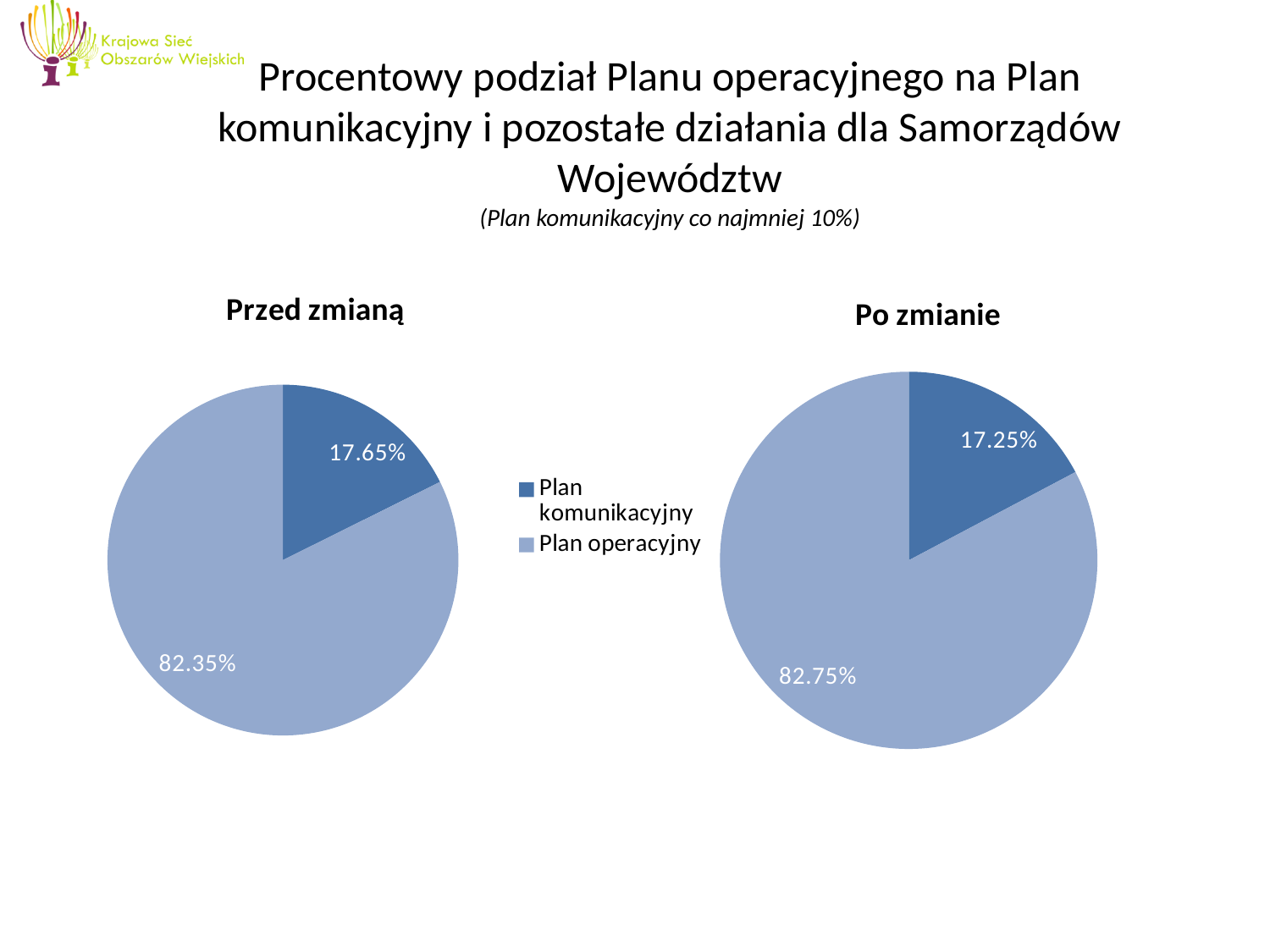
In the "Po zmianie" chart, what share does Plan operacyjny have? 82.75% In the "Przed zmianą" chart, what share does Plan komunikacyjny have? 17.65% In the "Po zmianie" chart, what share does Plan komunikacyjny have? 17.25% Is the Plan komunikacyjny share larger in the "Przed zmianą" chart or the "Po zmianie" chart? Przed zmianą In the "Przed zmianą" chart, what is the difference between the Plan operacyjny and Plan komunikacyjny shares? 64.70% How many slices does the "Przed zmianą" pie chart have? 2 How many entries does the legend list? 2 What type of chart is the "Po zmianie" chart? Pie chart What is the title of the chart on the right side of the slide? Po zmianie In the "Przed zmianą" chart, which category has the largest slice? Plan operacyjny In the "Przed zmianą" chart, what share does Plan operacyjny have? 82.35% In the "Po zmianie" chart, which category has the smallest slice? Plan komunikacyjny